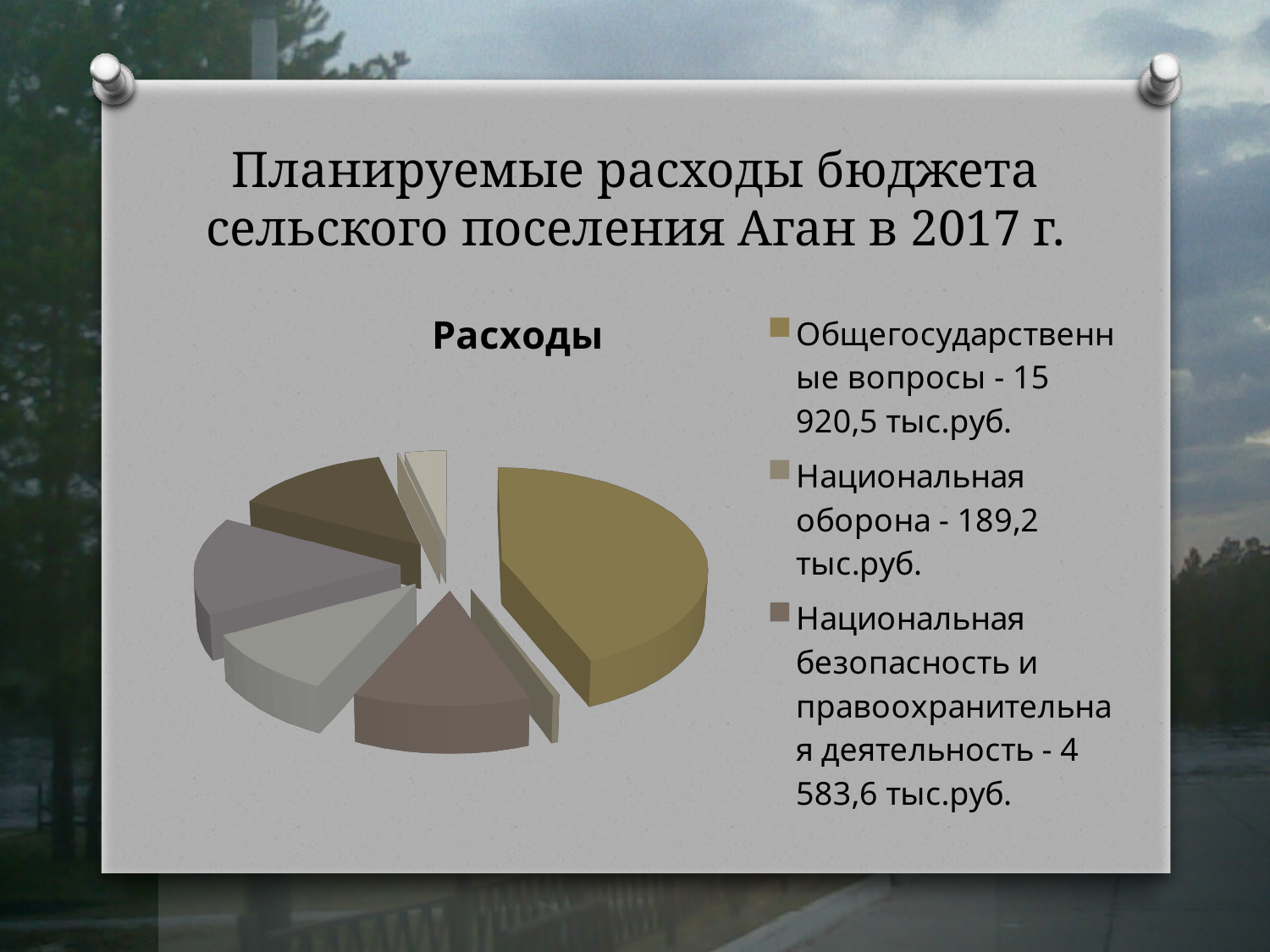
How many entries are listed in the legend? 3 What is the difference between Общегосударственные вопросы and Национальная безопасность и правоохранительная деятельность? 11 336,9 тыс.руб. Which is larger: Общегосударственные вопросы or Национальная оборона? Общегосударственные вопросы What is the planned expenditure for Национальная безопасность и правоохранительная деятельность? 4 583,6 тыс.руб. What is the difference between Общегосударственные вопросы and Национальная оборона? 15 731,3 тыс.руб. What is the title of the chart? Расходы Which category has the largest slice in the pie chart? Общегосударственные вопросы What is the planned expenditure for Национальная оборона? 189,2 тыс.руб. Which is larger: Национальная оборона or Национальная безопасность и правоохранительная деятельность? Национальная безопасность и правоохранительная деятельность What kind of chart is shown on the slide? Pie chart What is the planned expenditure for Общегосударственные вопросы? 15 920,5 тыс.руб. How many slices does the pie chart have? 8